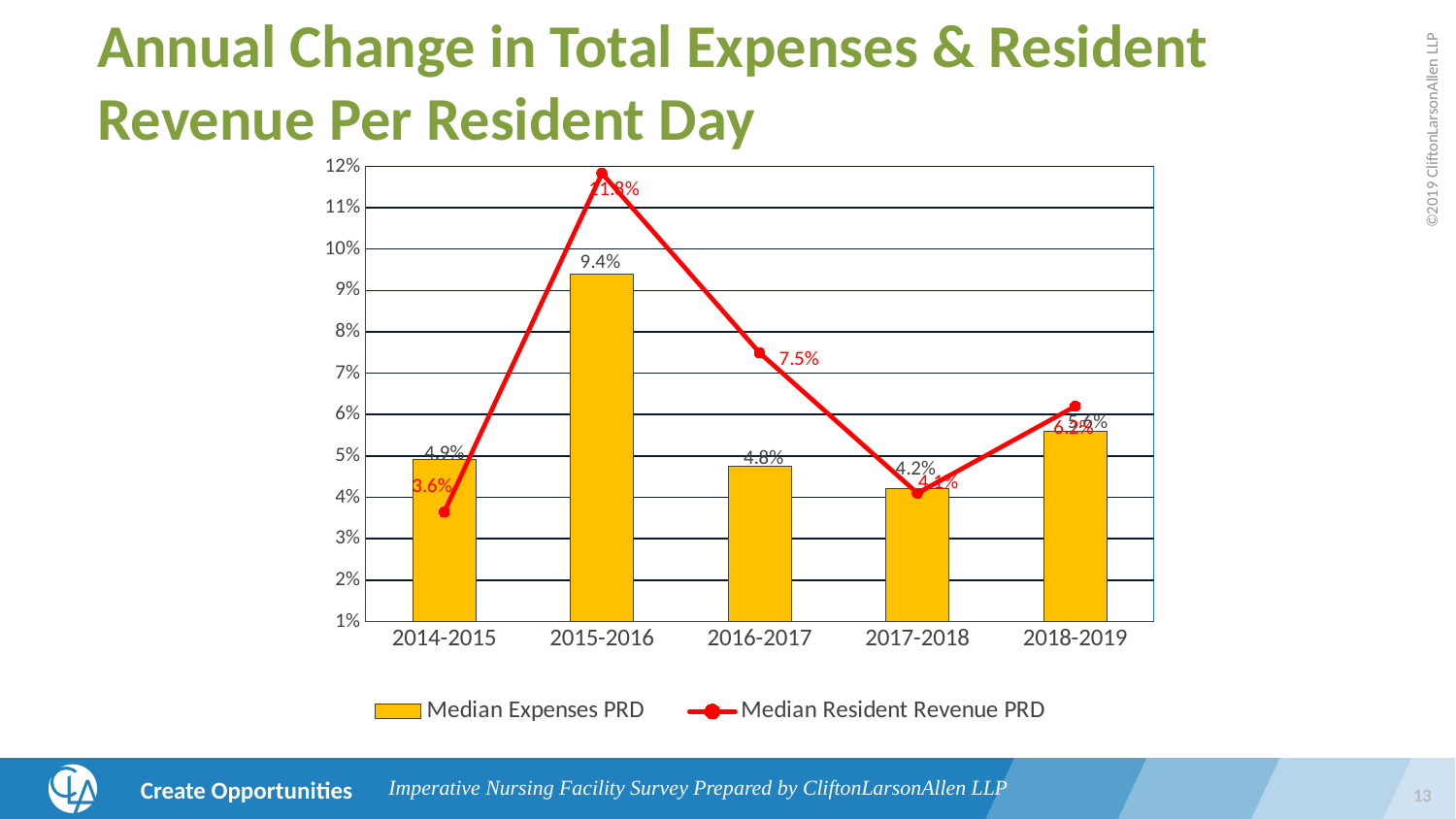
In 2014-2015, which is larger: Median Expenses PRD or Median Resident Revenue PRD? Median Expenses PRD What is the difference between Median Expenses PRD in 2015-2016 and in 2016-2017? 4.6 percentage points In which period is Median Expenses PRD lowest? 2017-2018 What is the Median Resident Revenue PRD value for 2016-2017? 7.5% What is the Median Expenses PRD value for 2017-2018? 4.2% What is the Median Resident Revenue PRD value for 2014-2015? 3.6% How many series does the legend list? 2 What kind of chart is shown on the slide? A combination bar and line chart In which period is Median Expenses PRD highest? 2015-2016 Is the Median Resident Revenue PRD value for 2015-2016 greater or less than 11%? greater What is the Median Expenses PRD value for 2015-2016? 9.4% How many year periods are shown on the x axis? 5